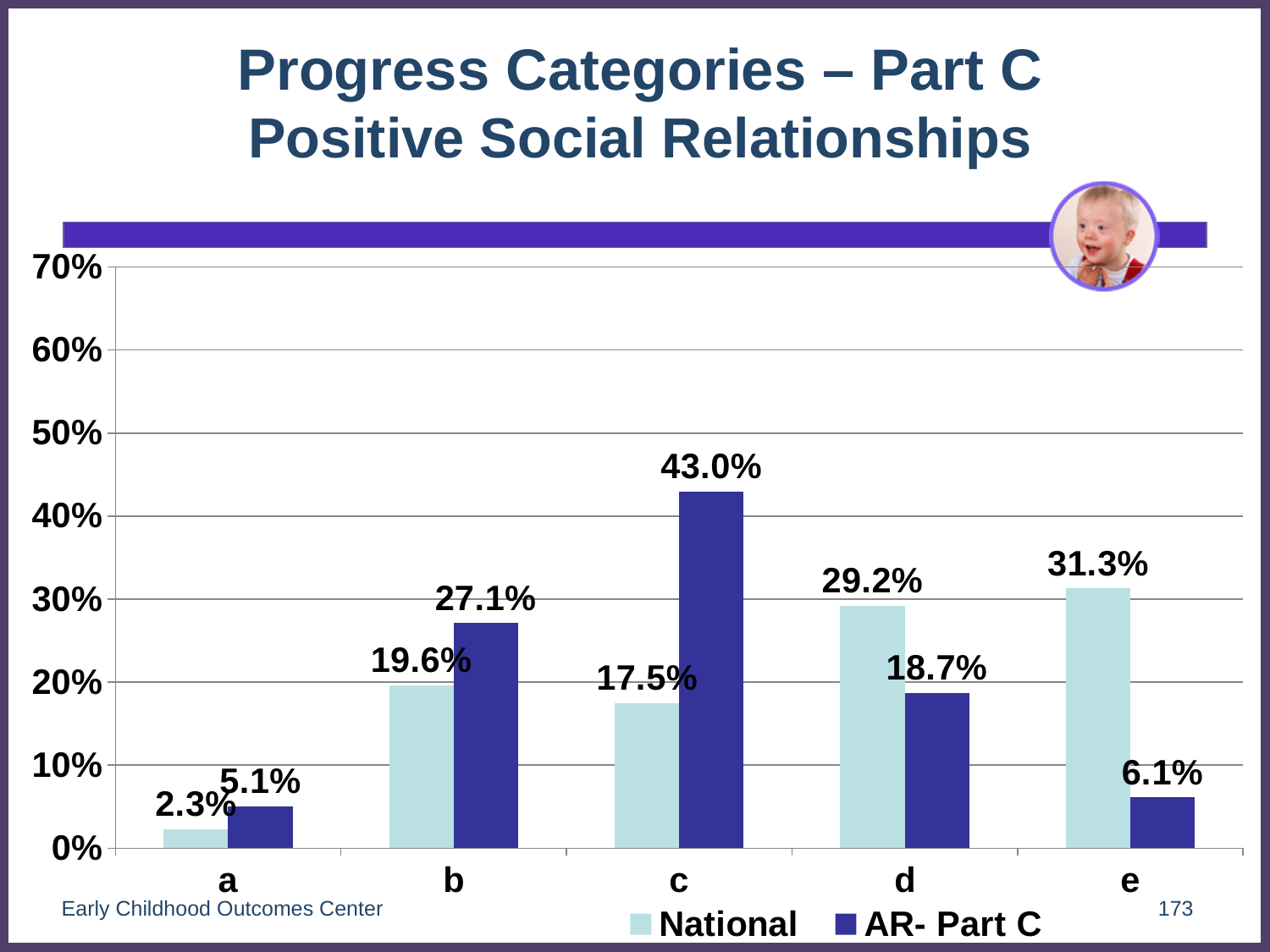
What is the National value for category e? 31.3% What is the AR- Part C value for category b? 27.1% How many categories are shown on the x axis? 5 What is the National value for category c? 17.5% Which category has the highest AR- Part C value? c What kind of chart is shown on the slide? bar chart Which is larger for category d, the National value or the AR- Part C value? National Which category has the lowest National value? a Is the AR- Part C value for category c greater or less than 40%? greater What is the difference between the AR- Part C and National values for category c? 25.5% How many series does the legend list? 2 What are the two series named in the legend? National and AR- Part C